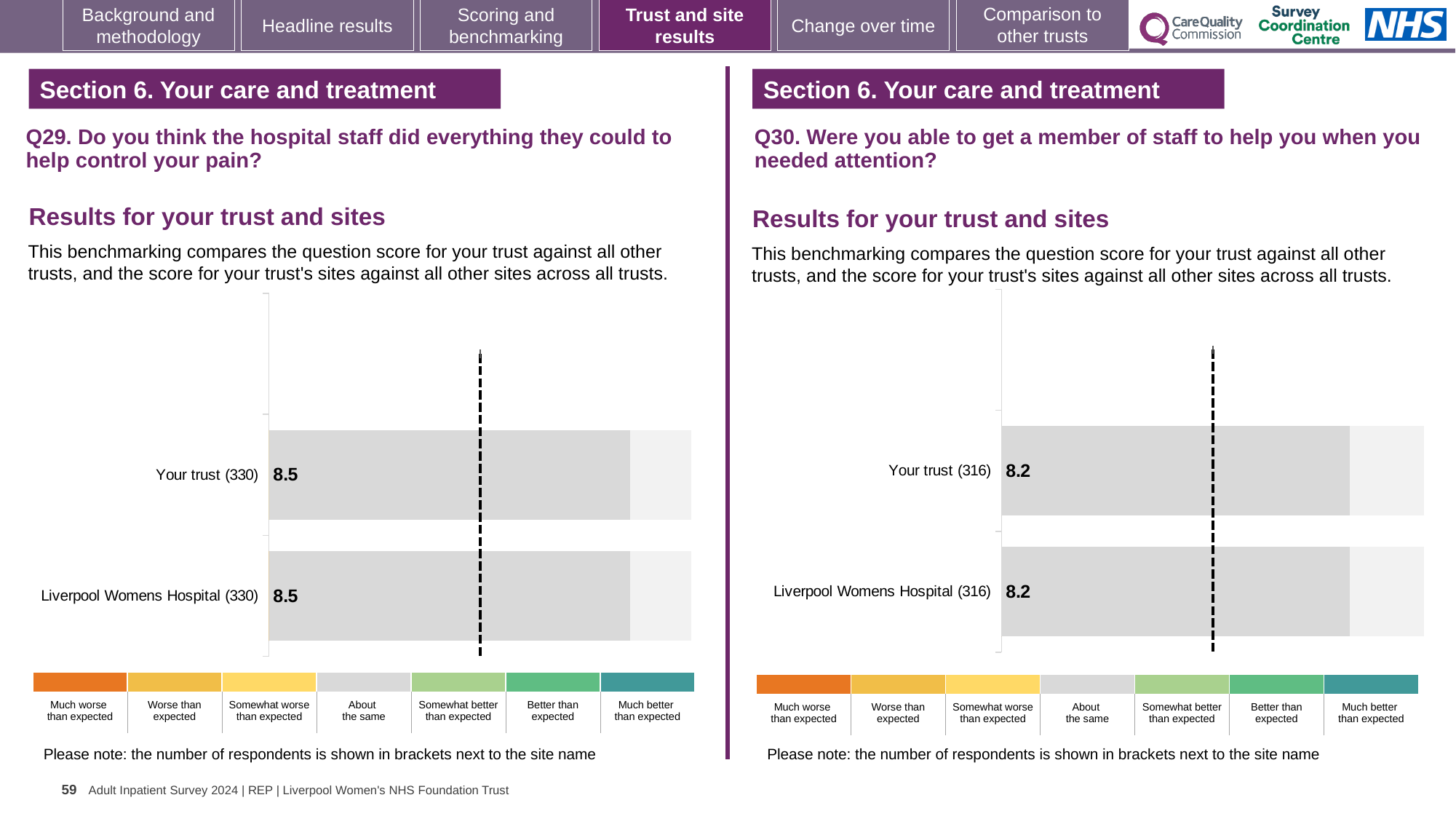
In the Q29 chart on the left, what is the score for Your trust? 8.5 How many bars are plotted in the Q30 chart on the right? 2 How many bars are plotted in the Q29 chart on the left? 2 What kind of chart is used in the Q29 chart on the left? Bar chart In the Q30 chart on the right, what is the score for Your trust? 8.2 Is the score for Your trust in the Q29 chart on the left larger than, smaller than, or equal to the score for Your trust in the Q30 chart on the right? Larger In the Q29 chart on the left, what is the difference between the score for Your trust and the score for Liverpool Womens Hospital? 0 In the Q30 chart on the right, what is the difference between the score for Your trust and the score for Liverpool Womens Hospital? 0 In the Q29 chart on the left, how many respondents are shown in brackets next to Liverpool Womens Hospital? 330 In the Q29 chart on the left, what is the score for Liverpool Womens Hospital? 8.5 In the Q30 chart on the right, what is the score for Liverpool Womens Hospital? 8.2 In the Q30 chart on the right, how many respondents are shown in brackets next to Your trust? 316